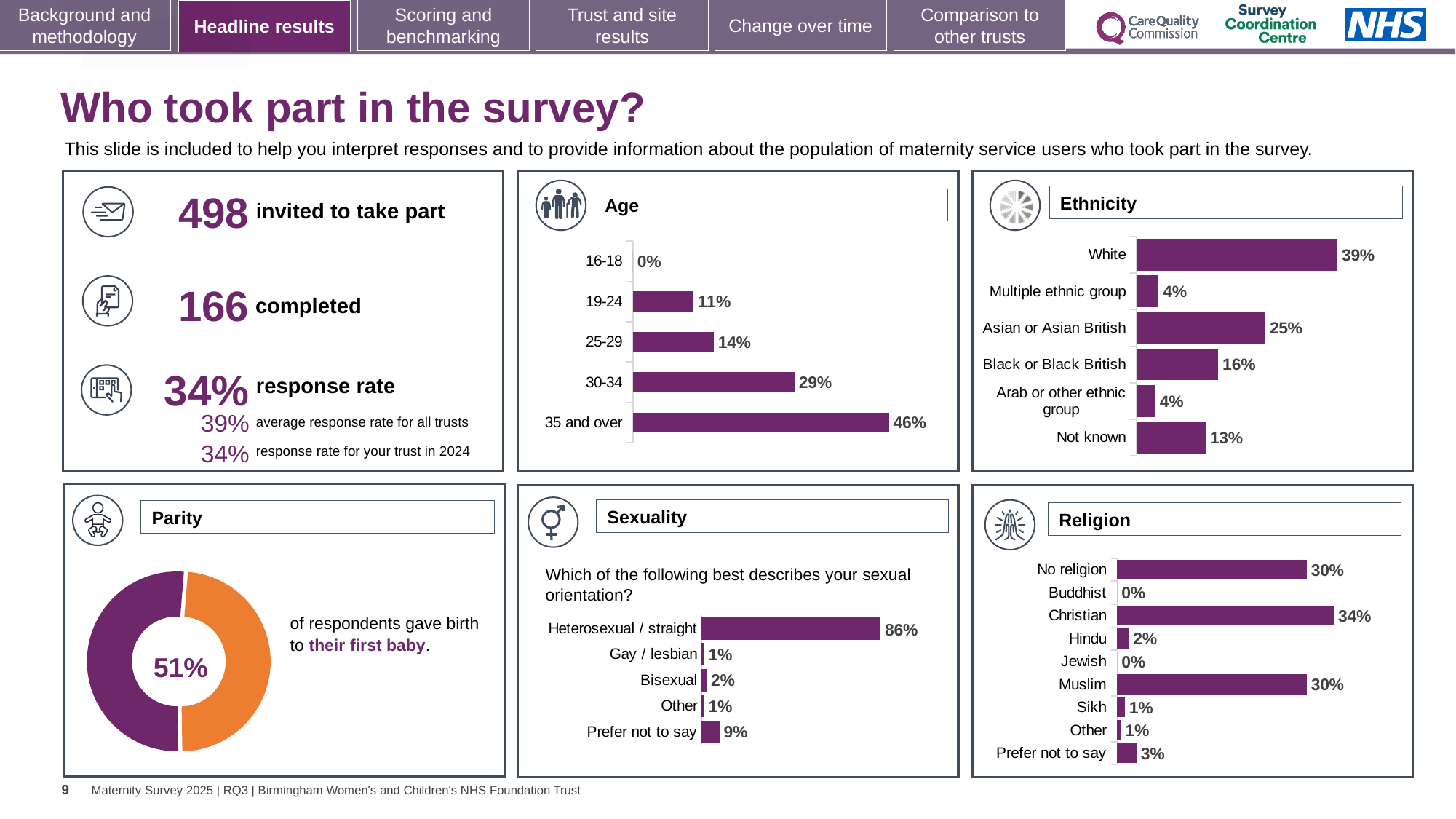
In the Religion chart, what percentage of respondents were Christian? 34% What kind of chart is the Parity chart? Doughnut (pie) chart In the Sexuality chart, which is larger, Bisexual or Gay / lesbian? Bisexual In the Ethnicity chart, which category has the highest percentage? White In the Age chart, how many age categories are shown? 5 In the Religion chart, how many religion categories are listed? 9 In the Parity chart, what percentage of respondents gave birth to their first baby? 51% In the Ethnicity chart, what is the difference between the White and Black or Black British percentages? 23% In the Sexuality chart, what percentage of respondents answered Prefer not to say? 9% In the Age chart, what percentage of respondents were aged 35 and over? 46% In the Age chart, which age group has the lowest percentage? 16-18 In the Ethnicity chart, what percentage of respondents were Asian or Asian British? 25%